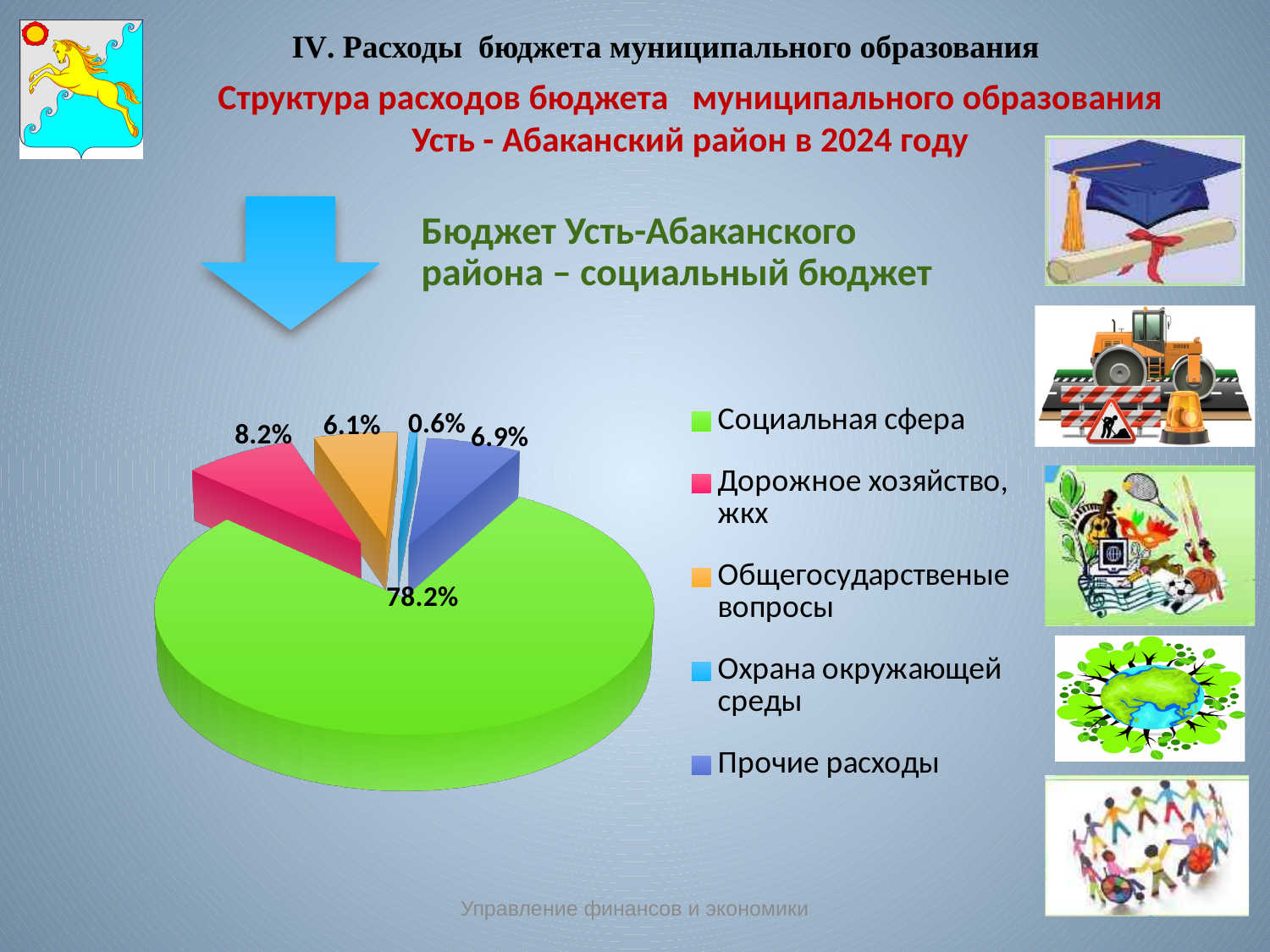
Which category has the smallest slice of the pie chart? Охрана окружающей среды Which is larger: Прочие расходы or Общегосударственые вопросы? Прочие расходы What is the value shown for Общегосударственые вопросы in the pie chart? 6.1% What colour is the slice for Социальная сфера in the pie chart? Green What is the value shown for Охрана окружающей среды in the pie chart? 0.6% What is the difference in percentage points between Дорожное хозяйство, жкх and Прочие расходы? 1.3 What is the value shown for Прочие расходы in the pie chart? 6.9% What type of chart is shown on the slide? Pie chart What is the value shown for Дорожное хозяйство, жкх in the pie chart? 8.2% Which category has the largest slice of the pie chart? Социальная сфера What share of the pie chart does Социальная сфера account for? 78.2% How many categories does the pie chart show? 5